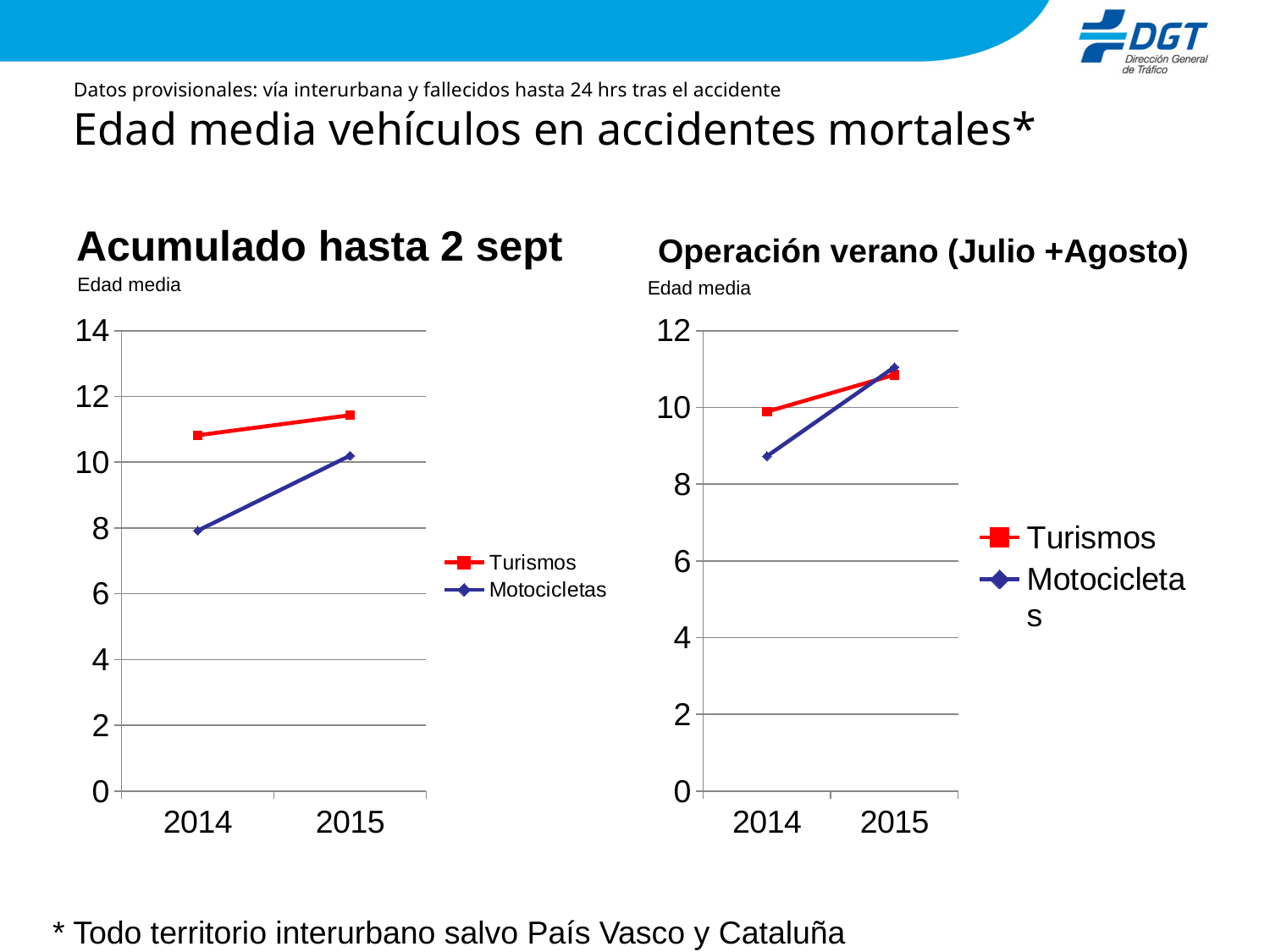
What type of chart is the 'Acumulado hasta 2 sept' chart? line chart In the 'Acumulado hasta 2 sept' chart, how many years are shown on the x axis? 2 In the 'Operación verano (Julio +Agosto)' chart, does the Turismos line rise or fall from 2014 to 2015? rise In the 'Acumulado hasta 2 sept' chart, is the value for Turismos in 2014 greater or less than 10? greater In the 'Acumulado hasta 2 sept' chart, is the value for Motocicletas in 2014 greater or less than 10? less What colour is the Motocicletas line in the 'Acumulado hasta 2 sept' chart? blue In the 'Operación verano (Julio +Agosto)' chart, is the value for Motocicletas in 2014 greater or less than 10? less How many series does the legend of the 'Operación verano (Julio +Agosto)' chart list? 2 In the 'Acumulado hasta 2 sept' chart, does the Motocicletas line rise or fall from 2014 to 2015? rise In the 'Acumulado hasta 2 sept' chart, which series has the higher value in 2014, Turismos or Motocicletas? Turismos In the 'Operación verano (Julio +Agosto)' chart, which series has the higher value in 2014, Turismos or Motocicletas? Turismos